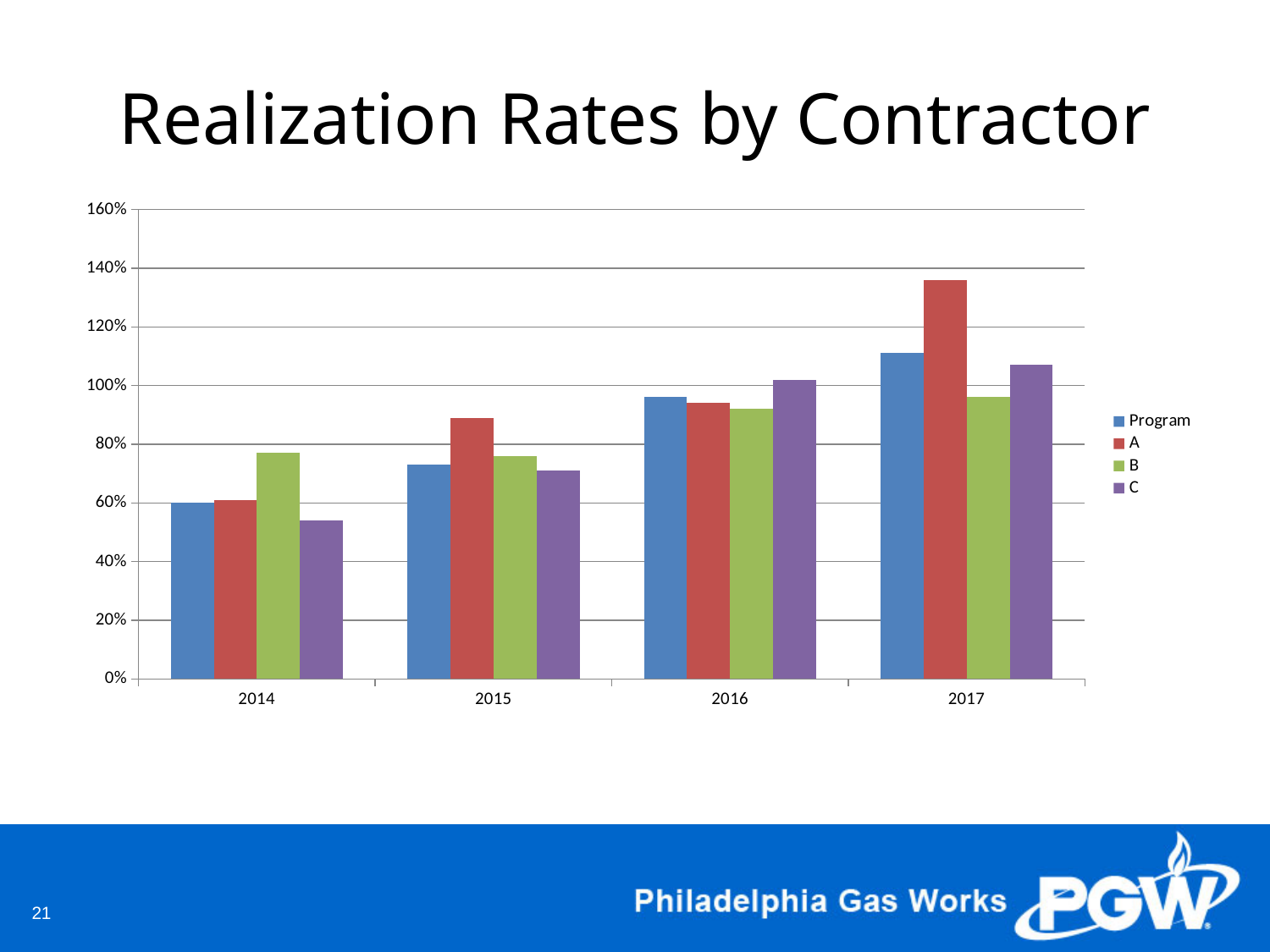
How many series does the legend list? 4 Is the value for contractor A in 2017 greater or less than 120%? greater How many years are shown on the x axis? 4 Do the Program values rise or fall from 2014 to 2017? rise In 2015, which is larger, the value for contractor A or contractor B? A In 2017, which is larger, the value for contractor A or contractor C? A In which year is the value for contractor A highest? 2017 Is the value for contractor B in 2017 greater or less than 80%? greater What is the title of the chart? Realization Rates by Contractor Is the value for contractor C in 2014 greater or less than 60%? less Which series has the lowest value in 2014? C What kind of chart is shown on the slide? bar chart